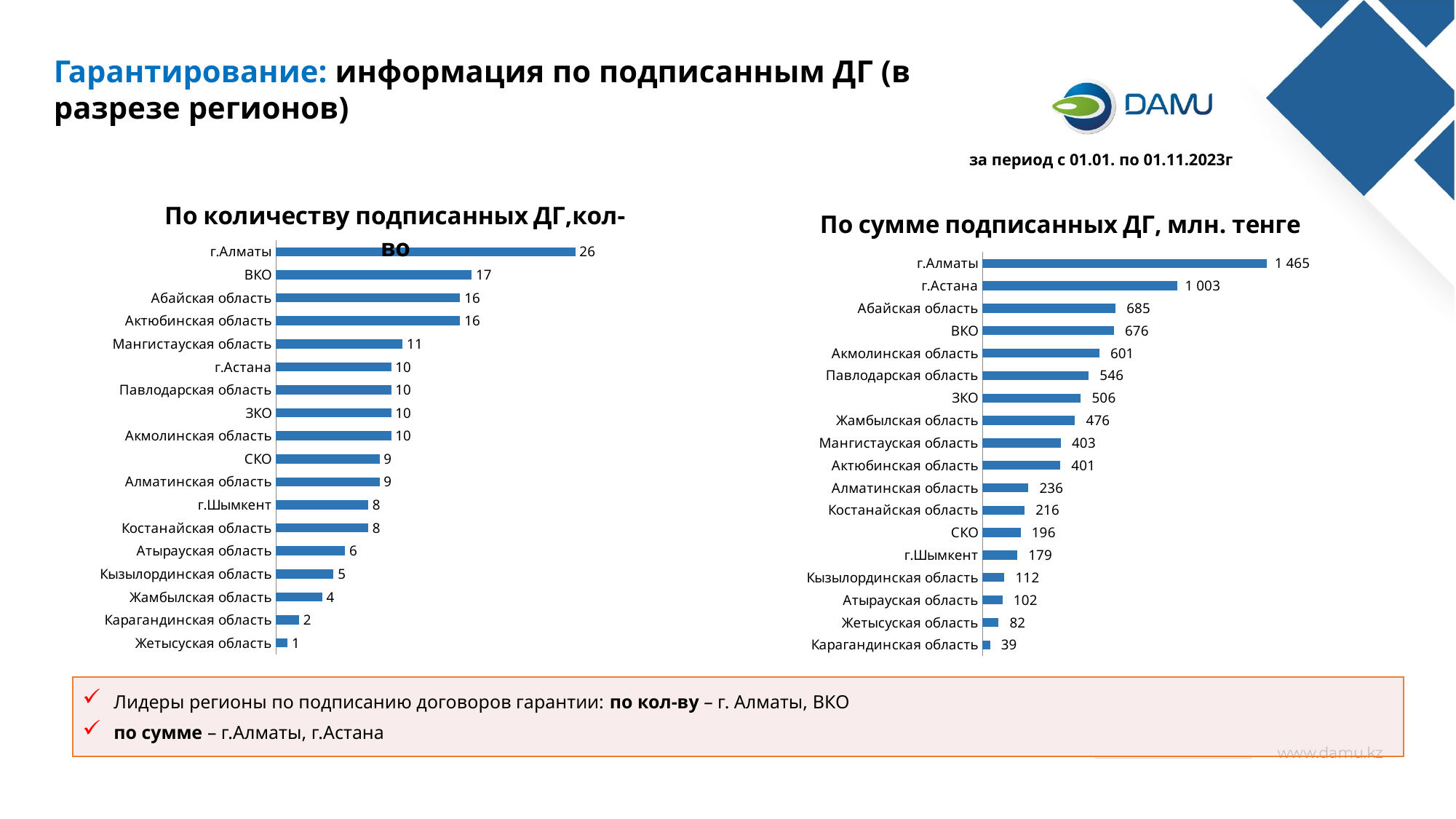
In the chart 'По сумме подписанных ДГ, млн. тенге', which region has the lowest value? Карагандинская область In the chart 'По количеству подписанных ДГ, кол-во', which is larger: Мангистауская область or г.Астана? Мангистауская область What type of chart is 'По количеству подписанных ДГ, кол-во'? Bar chart In the chart 'По количеству подписанных ДГ, кол-во', which region has the lowest value? Жетысуская область In the chart 'По сумме подписанных ДГ, млн. тенге', which is larger: Абайская область or ВКО? Абайская область In the chart 'По сумме подписанных ДГ, млн. тенге', what is the difference between г.Алматы and г.Астана? 462 In the chart 'По количеству подписанных ДГ, кол-во', what is the value for ВКО? 17 In the chart 'По количеству подписанных ДГ, кол-во', what is the difference between г.Алматы and ВКО? 9 In the chart 'По сумме подписанных ДГ, млн. тенге', what is the value for Павлодарская область? 546 In the chart 'По сумме подписанных ДГ, млн. тенге', what is the value for г.Астана? 1 003 In the chart 'По количеству подписанных ДГ, кол-во', which region has the highest value? г.Алматы How many regions are shown in the chart 'По сумме подписанных ДГ, млн. тенге'? 18